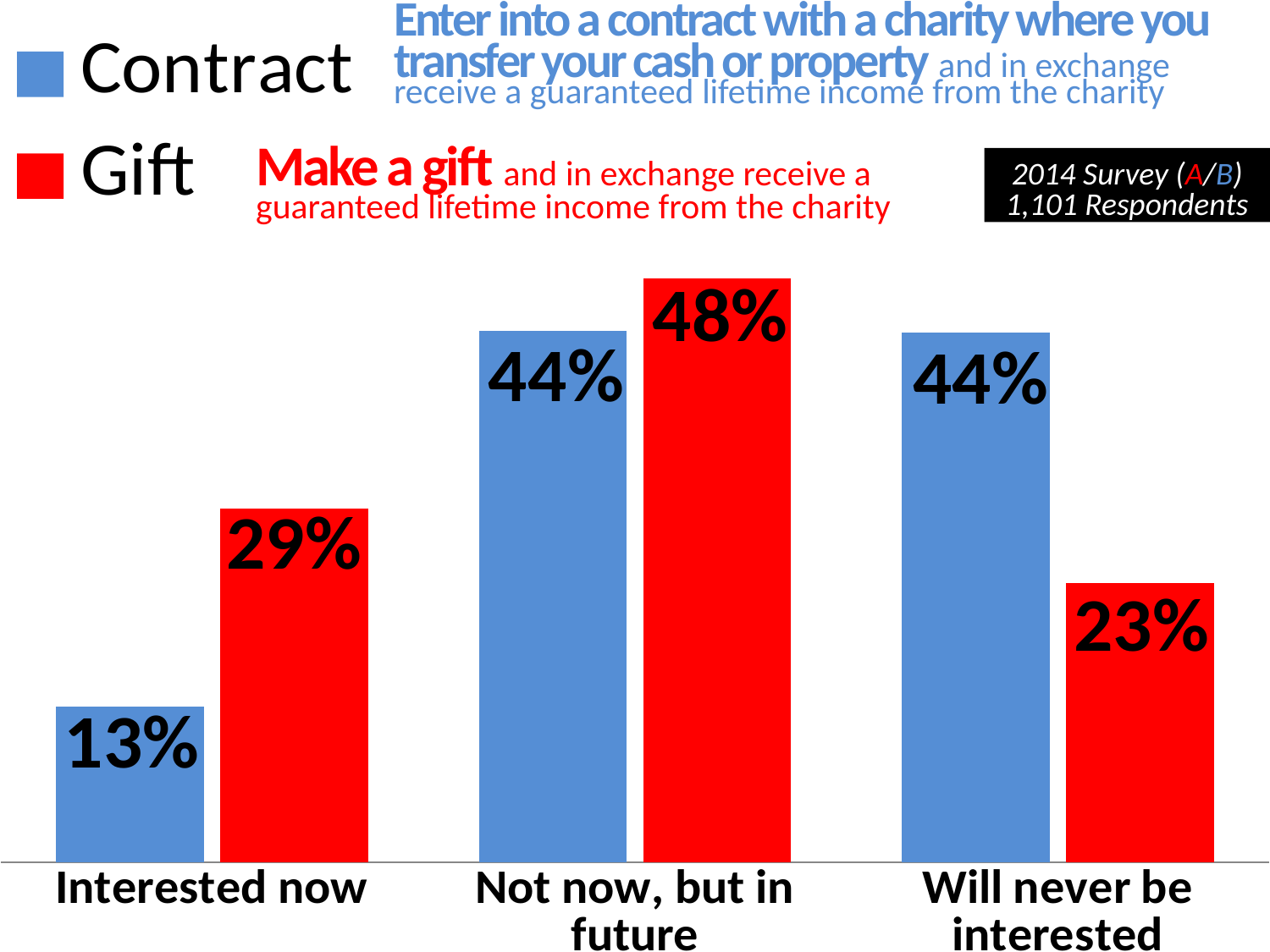
For "Not now, but in future", which is larger: Contract or Gift? Gift What is the Gift value for "Will never be interested"? 23% What is the Gift value for "Not now, but in future"? 48% How many series does the legend list? 2 What is the Contract value for "Will never be interested"? 44% How many categories are shown on the x axis? 3 What is the difference between the Gift and Contract values for "Interested now"? 16% What is the Contract value for "Interested now"? 13% Which category has the highest Gift value? Not now, but in future What kind of chart is shown on the slide? Bar chart Which category has the lowest Contract value? Interested now What is the difference between the Contract and Gift values for "Will never be interested"? 21%